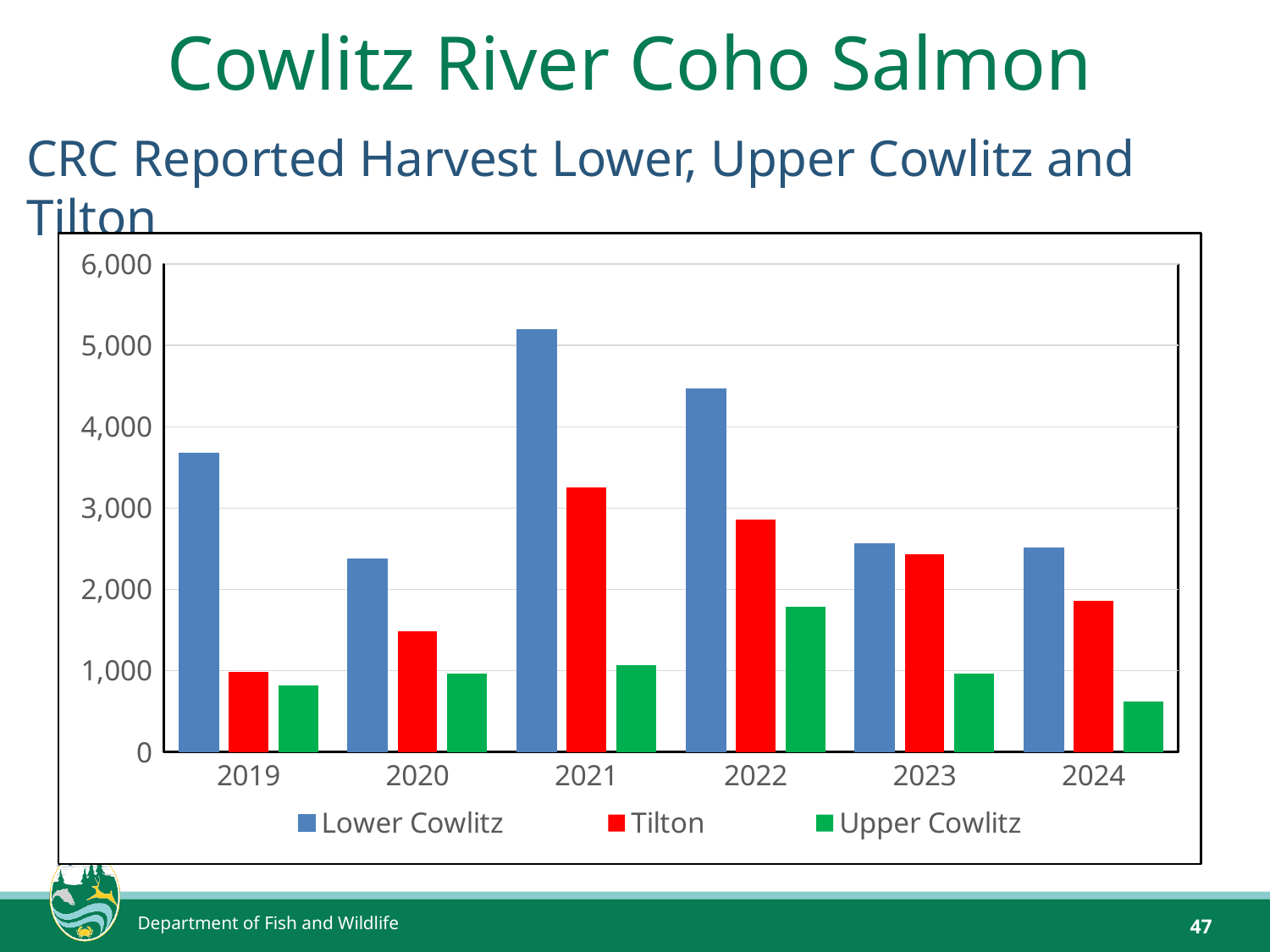
Do the Upper Cowlitz values rise or fall from 2022 to 2024? fall How many series does the legend list? 3 Is the value for Upper Cowlitz in 2022 greater or less than 1,000? greater In which year is the Tilton harvest highest? 2021 In which year is the Upper Cowlitz harvest lowest? 2024 What kind of chart is shown on the slide? bar chart Is the value for Lower Cowlitz in 2021 greater or less than 5,000? greater How many years are shown on the x axis? 6 Is the value for Tilton in 2019 greater or less than 2,000? less In 2020, which is larger: Tilton or Upper Cowlitz? Tilton In 2022, which is larger: Lower Cowlitz or Tilton? Lower Cowlitz In which year is the Lower Cowlitz harvest highest? 2021